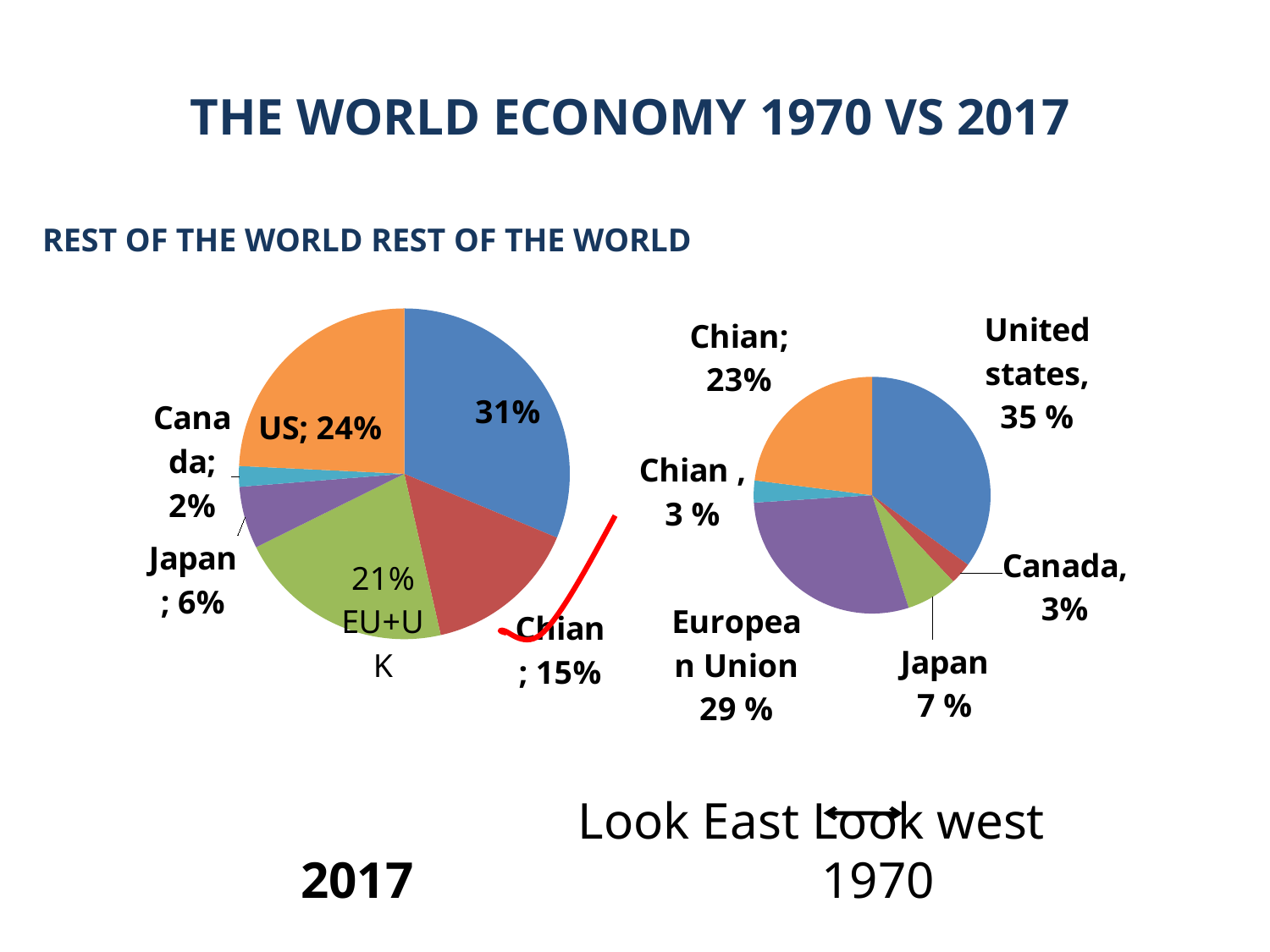
In the 2017 pie chart on the left, what share is shown for Canada? 2% What kind of chart is used on this slide for the 2017 data? pie chart In the 2017 pie chart on the left, what share is shown for the US? 24% How many slices does the 2017 pie chart on the left have? 6 In the 1970 pie chart on the right, what share is shown for Japan? 7 % In the 2017 pie chart on the left, what share is shown for EU+UK? 21% In the 1970 pie chart on the right, which is larger: the United states share or the European Union share? United states Comparing the two charts, is Japan's share larger in the 2017 chart or the 1970 chart? 1970 In the 1970 pie chart on the right, what share is shown for the European Union? 29 % In the 2017 pie chart on the left, what share is shown for Japan? 6% In the 1970 pie chart on the right, what share is shown for the United states? 35 % In the 2017 pie chart on the left, how many percentage points larger is the US share than the Japan share? 18%